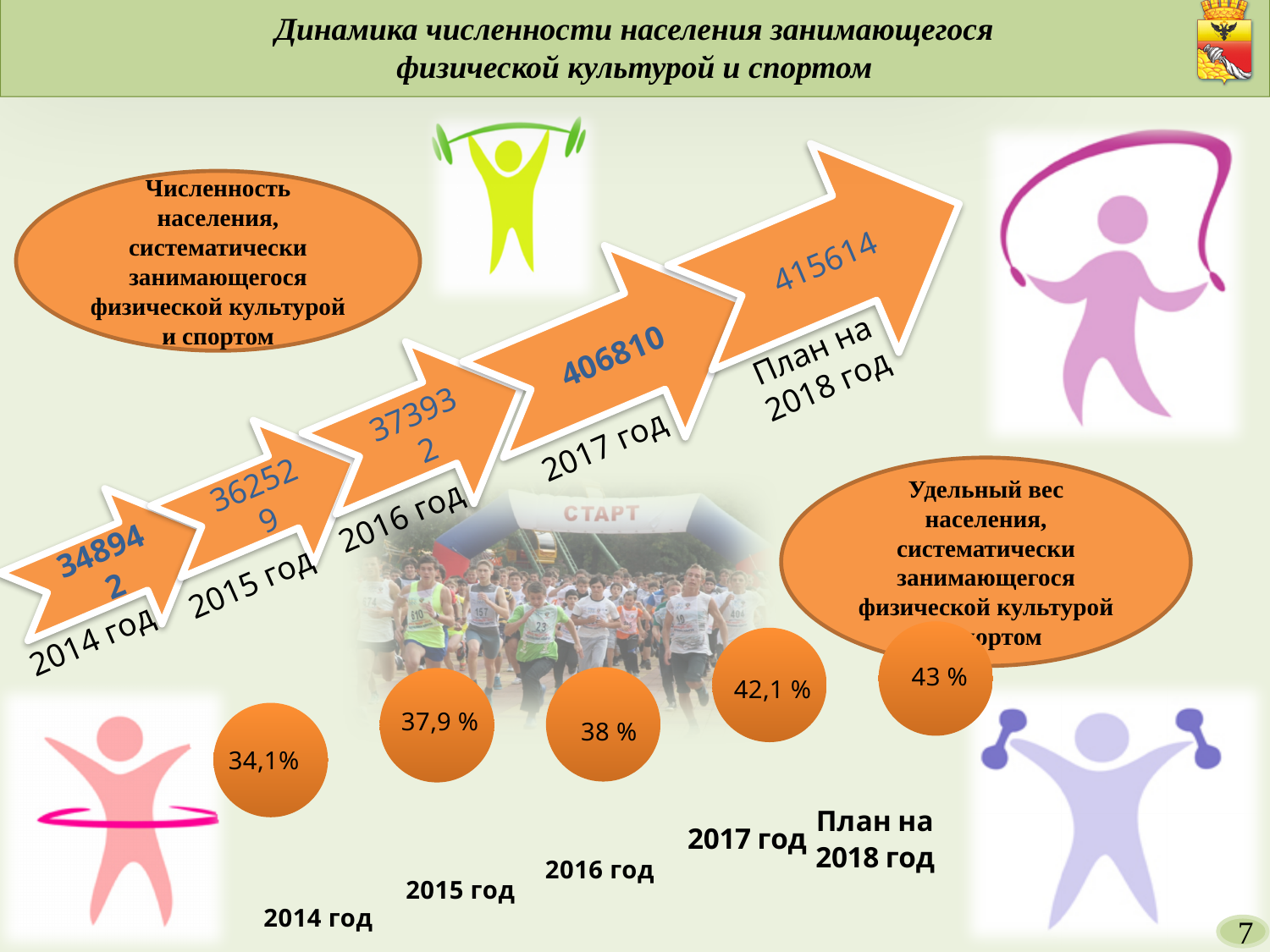
In the bottom circle diagram, which year has the lowest share? 2014 год In the top arrow diagram, what is the planned value for 2018 год (План на 2018 год)? 415614 In the bottom circle diagram (share of population systematically engaged in physical culture and sport), what is the value for 2014 год? 34,1% In the top arrow diagram (number of people systematically engaged in physical culture and sport), what is the value for 2017 год? 406810 In the top arrow diagram, what is the value for 2014 год? 348942 In the top arrow diagram, what is the value for 2015 год? 362529 In the top arrow diagram, what is the difference between the 2018 plan value and the 2017 value? 8804 In the bottom circle diagram, which is larger: the value for 2015 год or the value for 2016 год? 2016 год In the top arrow diagram, how many years (including the 2018 plan) are shown? 5 In the bottom circle diagram, what is the value for 2016 год? 38 % In the top arrow diagram, do the values rise or fall from 2014 год to the 2018 plan? rise In the bottom circle diagram, what is the value for 2017 год? 42,1 %